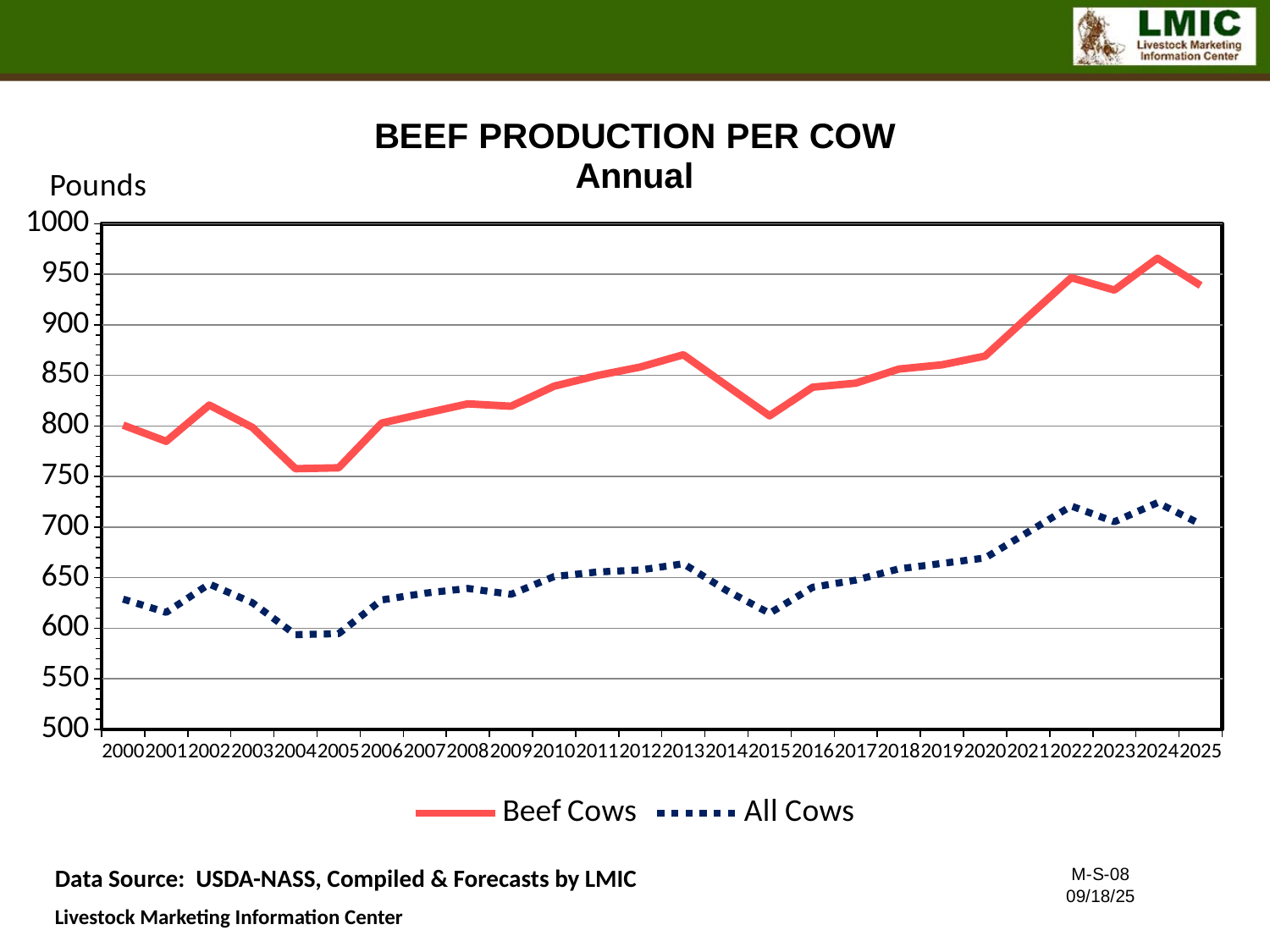
What unit is shown on the y axis label? Pounds Which year has the highest value for Beef Cows? 2024 How many series does the legend list? 2 Is the value for All Cows in 2022 greater or less than 700? greater Is the value for All Cows in 2015 greater or less than 650? less Is the value for Beef Cows in 2004 greater or less than 800? less Which series has the higher value in 2020, Beef Cows or All Cows? Beef Cows Which year has the higher value for Beef Cows, 2013 or 2015? 2013 Overall, do the Beef Cows values rise or fall from 2000 to 2025? Rise What kind of chart is shown on the slide? Line chart How many years are plotted along the x axis? 26